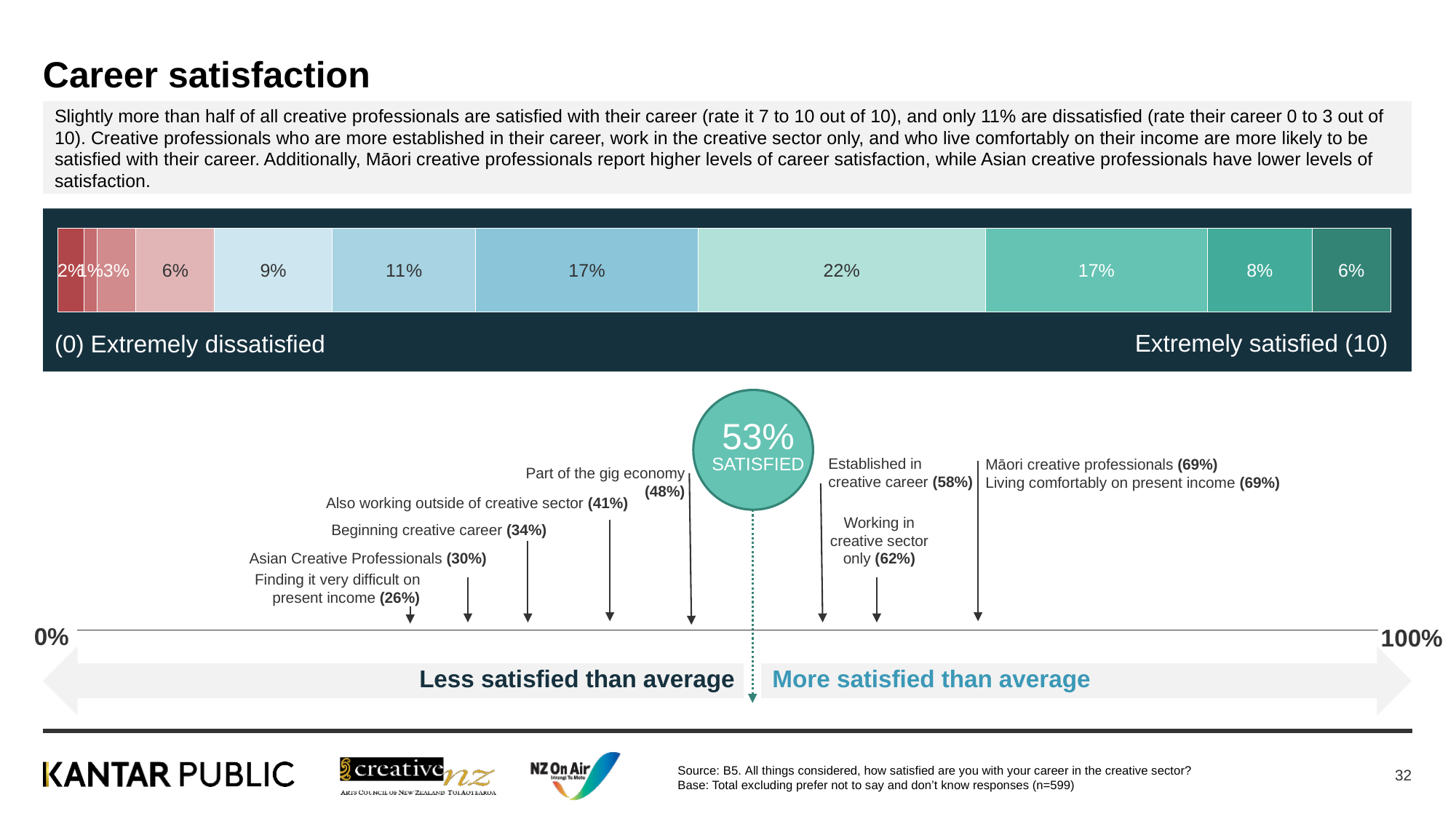
In the lower diagram, which group has the higher satisfaction: 'Established in creative career' or 'Working in creative sector only'? Working in creative sector only In the lower diagram, what is the satisfaction percentage for Māori creative professionals? 69% What kind of chart is the top chart on the slide showing the distribution of career satisfaction ratings? Stacked bar chart In the top stacked bar, what is the largest segment's value? 22% In the lower diagram, what percentage of all creative professionals are shown as satisfied? 53% In the lower diagram, what is the difference in percentage points between Māori creative professionals (69%) and Asian Creative Professionals (30%)? 39 percentage points In the lower diagram, what is the satisfaction percentage for Asian Creative Professionals? 30% In the top stacked bar, what is the value of the segment at the far right end (Extremely satisfied, 10)? 6% How many segments does the top stacked bar contain? 11 In the top stacked bar, what is the value of the segment at the far left end (Extremely dissatisfied, 0)? 2% In the lower diagram, how many groups are shown as less satisfied than average? 5 In the top stacked bar, what is the smallest segment's value? 1%